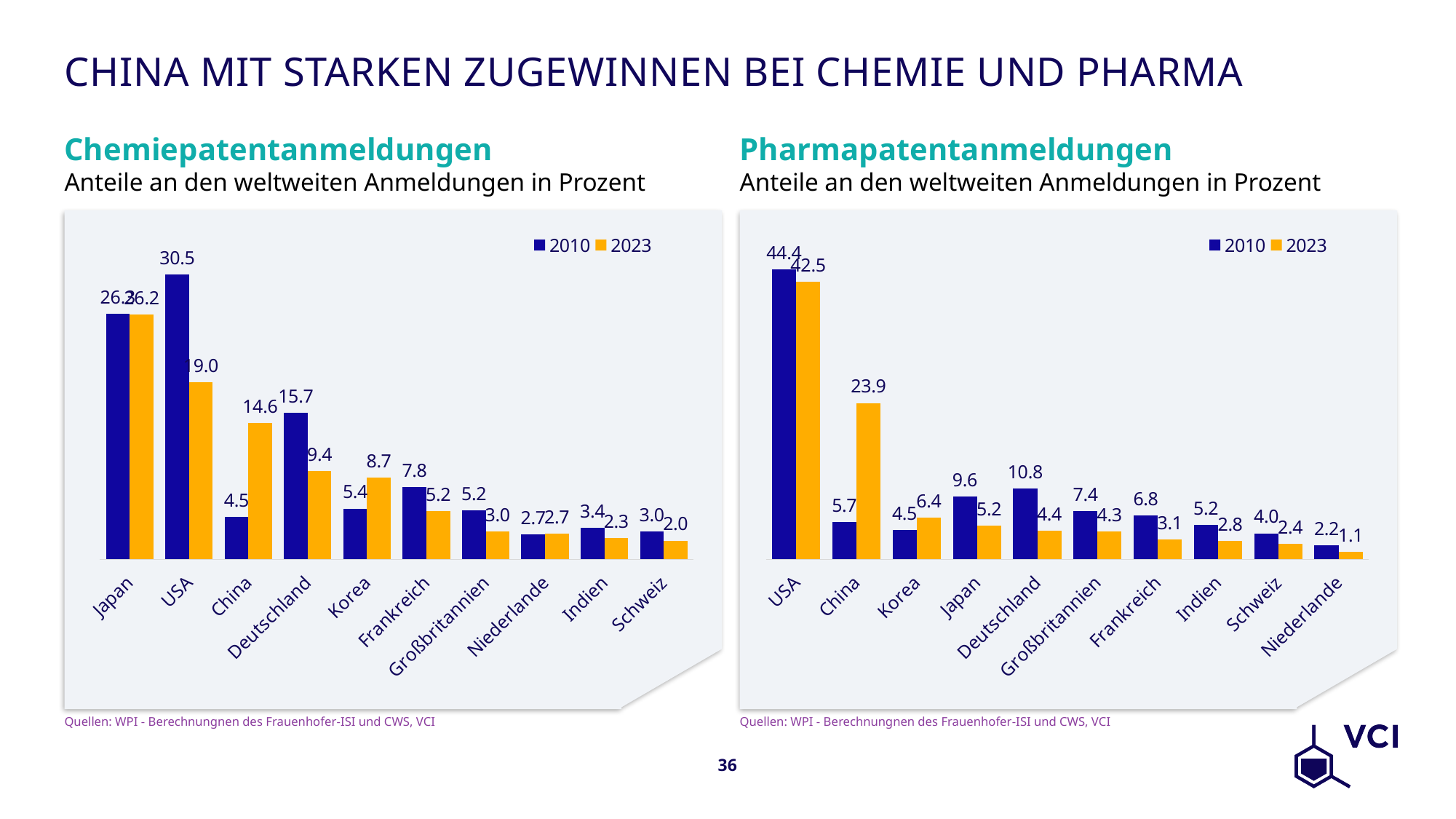
In the Chemiepatentanmeldungen chart, what is the value for China in 2023? 14.6 In the Pharmapatentanmeldungen chart, what is the difference between China's 2023 and 2010 values? 18.2 In the Chemiepatentanmeldungen chart, which country has the highest value for 2010? USA How many series does the legend of the Pharmapatentanmeldungen chart list? 2 What type of chart is the Pharmapatentanmeldungen chart? Bar chart In the Chemiepatentanmeldungen chart, what is the value for the USA in 2010? 30.5 In the Pharmapatentanmeldungen chart, what is the value for Deutschland in 2010? 10.8 How many countries are shown in the Chemiepatentanmeldungen chart? 10 In the Chemiepatentanmeldungen chart, which is larger for Korea: the 2010 value or the 2023 value? 2023 In the Pharmapatentanmeldungen chart, which country has the lowest value for 2023? Niederlande In the Pharmapatentanmeldungen chart, what is the value for China in 2023? 23.9 In the Chemiepatentanmeldungen chart, by how much did the USA's share fall from 2010 to 2023? 11.5